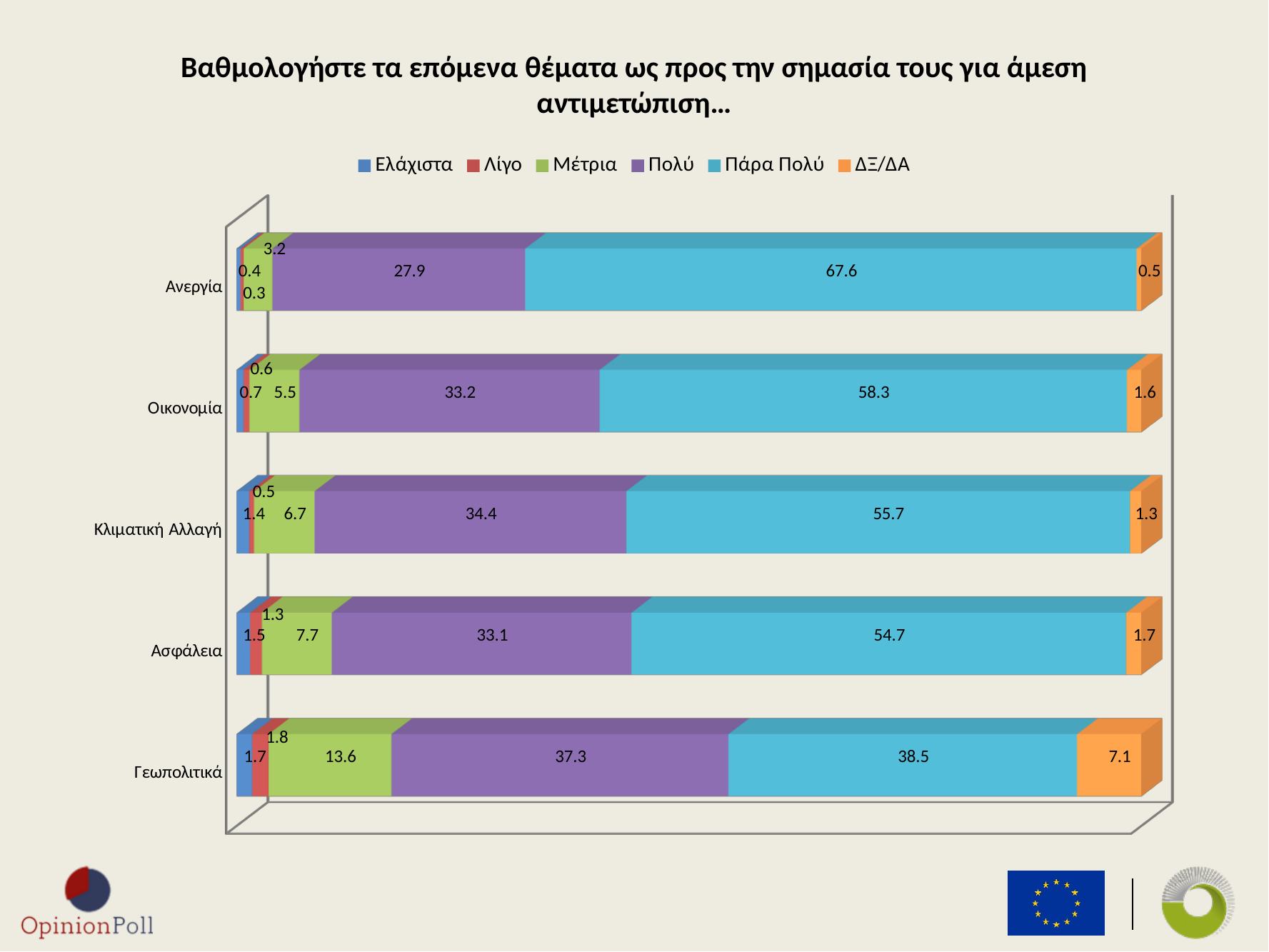
What kind of chart is shown on the slide? Stacked bar chart Which category has the highest 'Πάρα Πολύ' value? Ανεργία How many categories (topics) are plotted on the chart? 5 Which category has the lowest 'Πάρα Πολύ' value? Γεωπολιτικά What is the value of 'Μέτρια' for 'Οικονομία'? 5.5 Which category has the highest 'Μέτρια' value? Γεωπολιτικά How many series does the legend list? 6 What is the difference between the 'Πάρα Πολύ' values for 'Ανεργία' and 'Οικονομία'? 9.3 What is the value of 'Πολύ' for 'Γεωπολιτικά'? 37.3 What is the value of 'Πάρα Πολύ' for 'Ανεργία'? 67.6 What is the value of 'ΔΞ/ΔΑ' for 'Γεωπολιτικά'? 7.1 Which has the larger 'Πολύ' value, 'Κλιματική Αλλαγή' or 'Ασφάλεια'? Κλιματική Αλλαγή